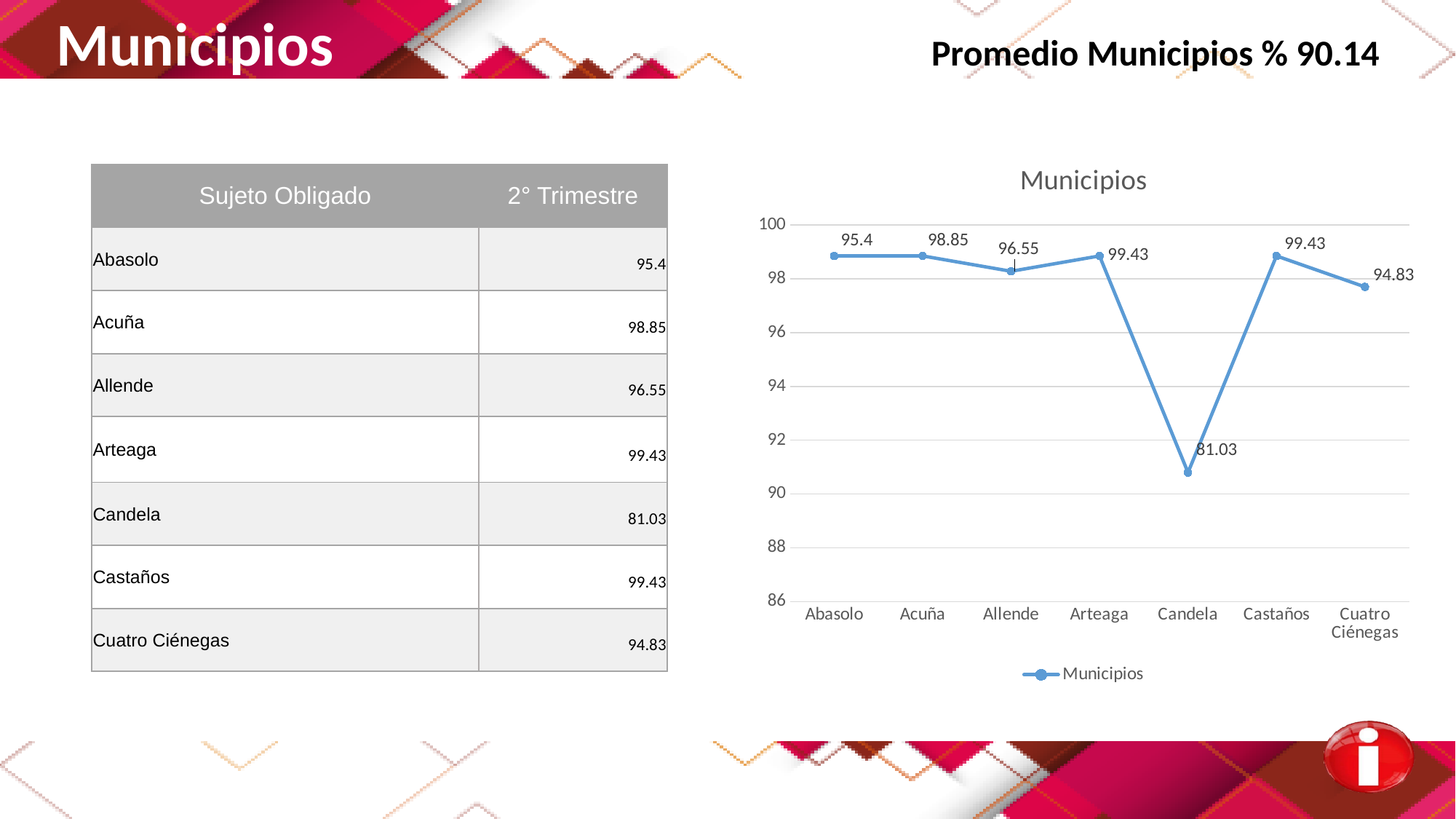
What is the value for Candela in the Municipios chart? 81.03 What kind of chart is the Municipios chart? Line chart How many categories are plotted on the x axis of the Municipios chart? 7 How many series does the legend of the Municipios chart list? 1 What is the value for Allende in the Municipios chart? 96.55 What is the value for Abasolo in the Municipios chart? 95.4 Does the line in the Municipios chart rise or fall from Candela to Castaños? Rise What is the value for Cuatro Ciénegas in the Municipios chart? 94.83 Which category has the lowest value in the Municipios chart? Candela What is the difference between the values for Acuña and Abasolo in the Municipios chart? 3.45 What is the difference between the values for Castaños and Cuatro Ciénegas in the Municipios chart? 4.6 Which has a larger value in the Municipios chart, Acuña or Allende? Acuña